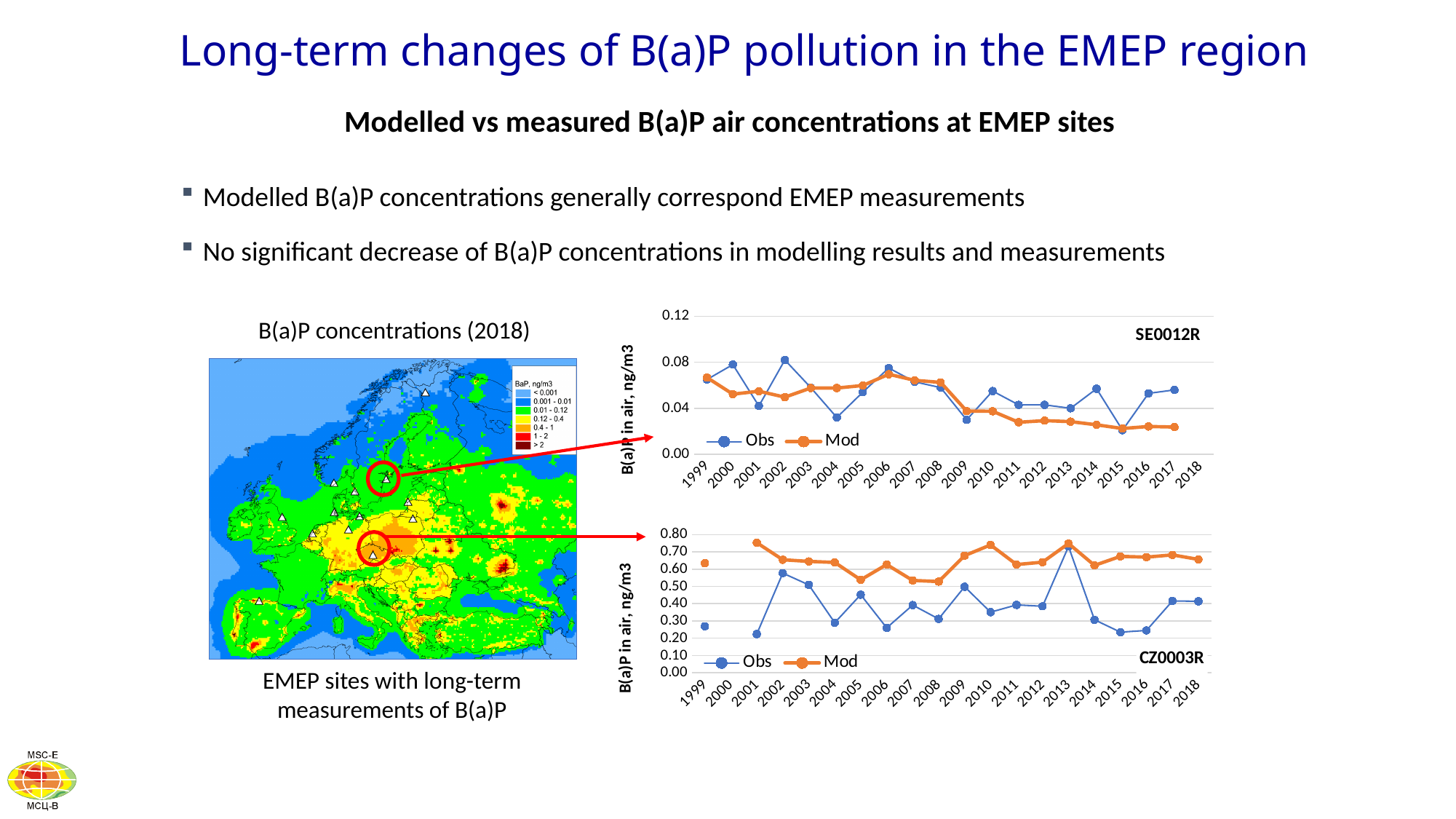
How many series does the legend of the CZ0003R chart list? 2 In the SE0012R chart, is the Obs value for 2006 greater or less than 0.04? greater In the SE0012R chart, which is larger in 2004, the Obs value or the Mod value? Mod In the CZ0003R chart, is the Obs value for 2001 greater or less than 0.30? less In the SE0012R chart, is the Mod value for 2017 greater or less than 0.04? less How many years are labelled on the x axis of the CZ0003R chart? 20 In the SE0012R chart, does the Mod series generally rise or fall from 1999 to 2017? fall What are the two series named in the legend of the SE0012R chart? Obs and Mod In the CZ0003R chart, which is larger in 2015, the Obs value or the Mod value? Mod What kind of chart is the SE0012R chart on the right of the slide? line chart